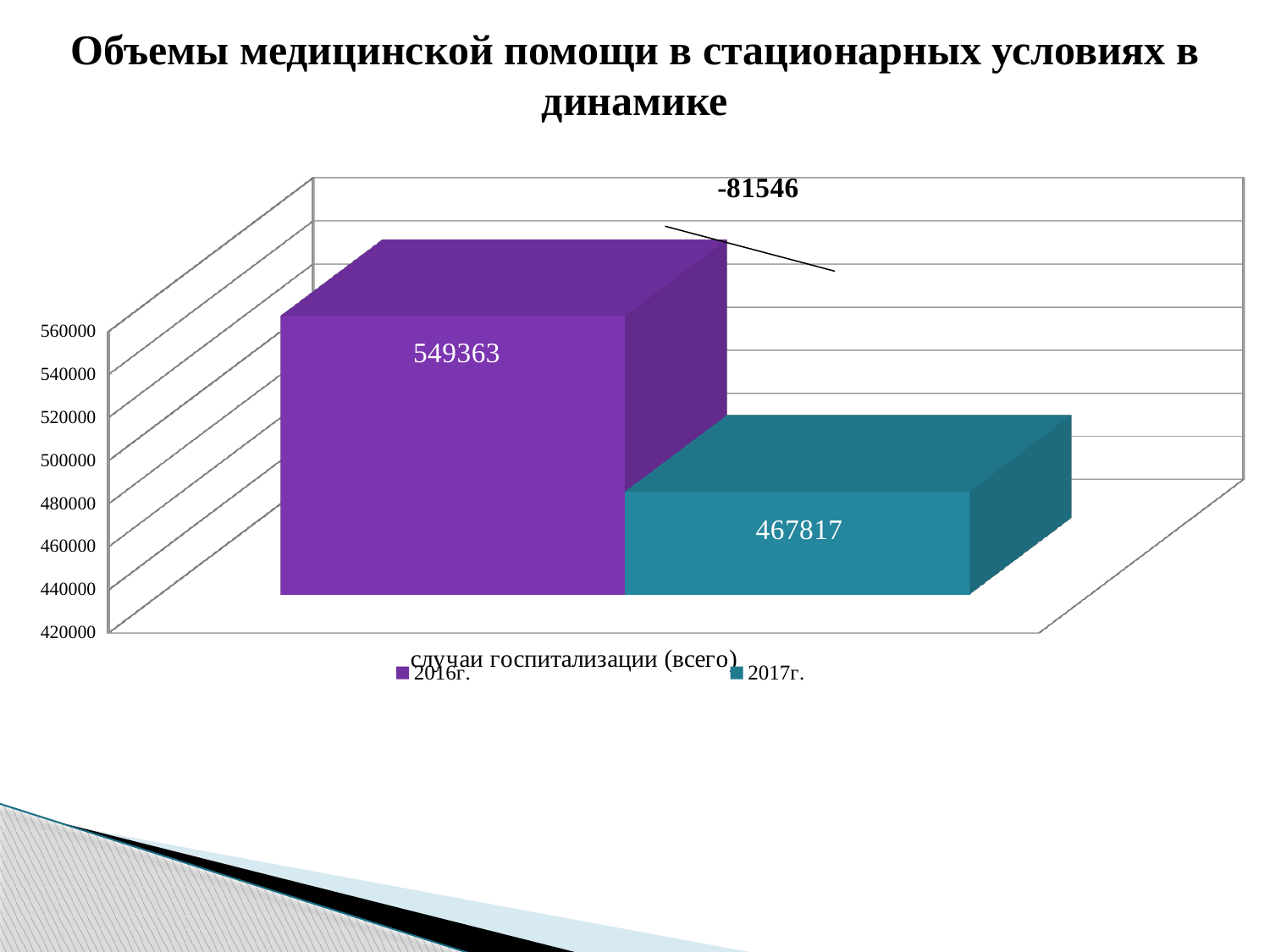
What is the value for 2016г. in the chart? 549363 Which series has the lowest value in the chart? 2017г. Which series has the highest value in the chart? 2016г. What is the title of the slide? Объемы медицинской помощи в стационарных условиях в динамике What change from 2016г. to 2017г. is annotated on the chart? -81546 What is the difference between the 2016г. value and the 2017г. value? 81546 How many series does the legend list? 2 Is the value for 2016г. greater or less than 540000? greater Is the value for 2017г. greater or less than 480000? less What is the value for 2017г. in the chart? 467817 What kind of chart is shown on the slide? bar chart Which year has the higher value, 2016г. or 2017г.? 2016г.